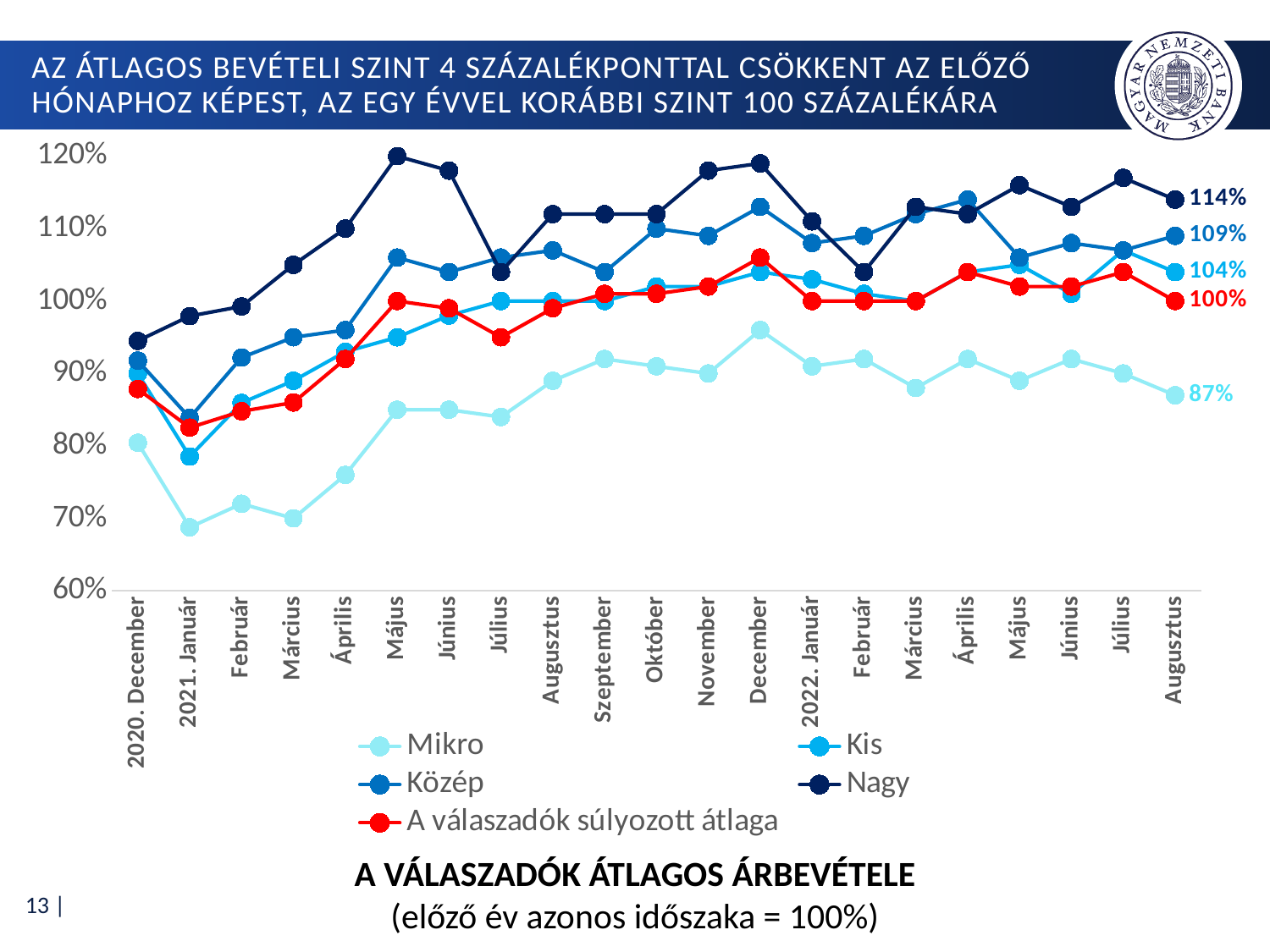
How many months (data points) are shown on the x axis? 21 What is the value of the Nagy series in 2022 Augusztus? 114% What kind of chart is shown on the slide? Line chart What is the difference between the Nagy and Mikro values in 2022 Augusztus? 27 percentage points What is the value of the Mikro series in 2022 Augusztus? 87% How many series does the legend list? 5 What is the value of the Kis series in 2022 Augusztus? 104% Which series has the highest value in 2022 Augusztus? Nagy What is the value of 'A válaszadók súlyozott átlaga' in 2022 Augusztus? 100% Which series has the lowest value in 2022 Augusztus? Mikro Is the value for Mikro in 2021. Január greater or less than 70%? less What is the value of the Közép series in 2022 Augusztus? 109%